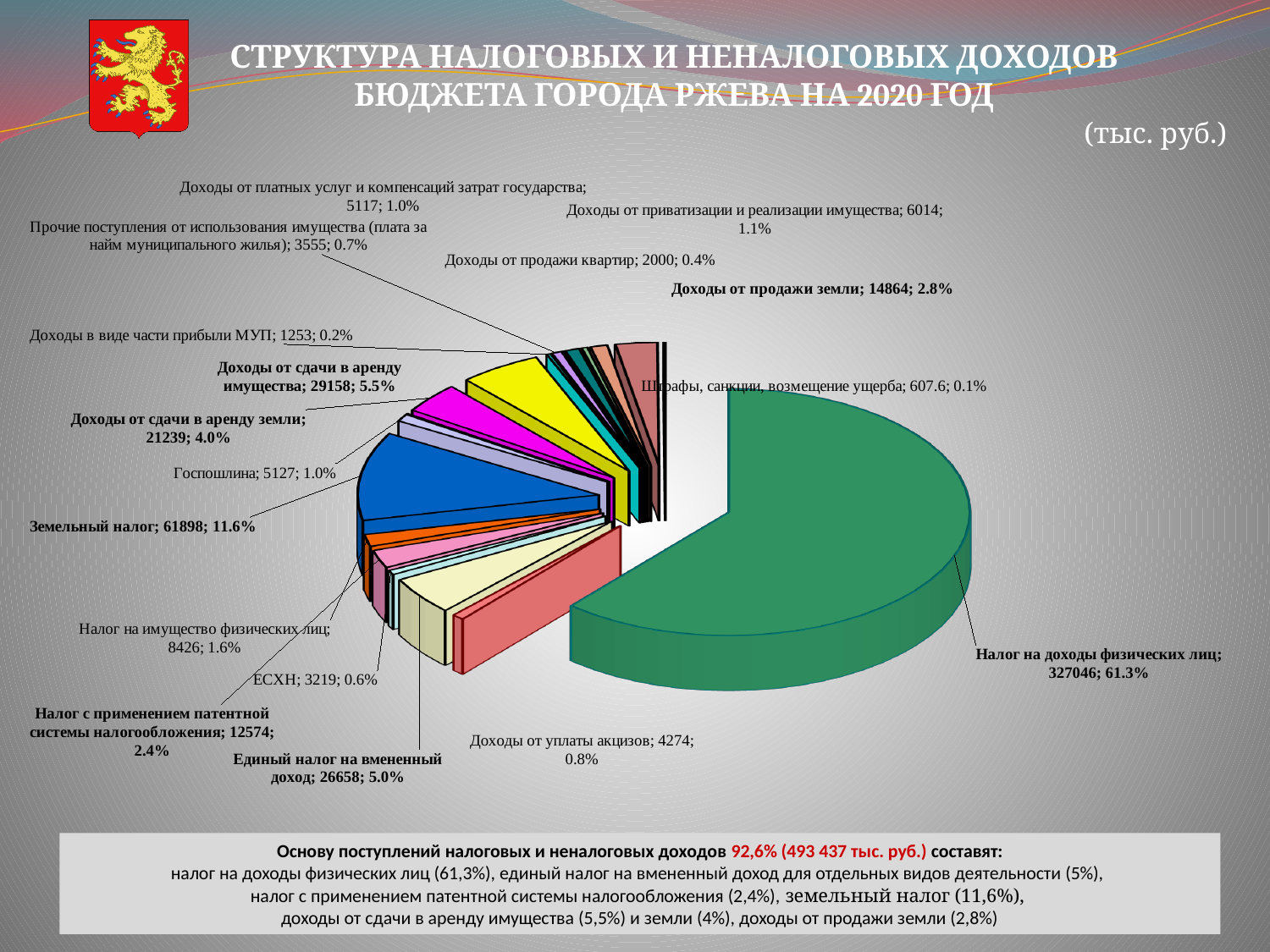
What is the value for Налог на доходы физических лиц? 327046 What kind of chart is shown on the slide? pie chart What share of the pie does Налог на доходы физических лиц represent? 61.3% What unit is stated for the values in the chart? тыс. руб. What is the value for Доходы от продажи земли? 14864 What is the value for Земельный налог? 61898 What is the difference between the values for Доходы от сдачи в аренду имущества and Доходы от сдачи в аренду земли? 7919 What share of the pie does Доходы от сдачи в аренду имущества represent? 5.5% Which category has the largest slice of the pie? Налог на доходы физических лиц Which is larger: Единый налог на вмененный доход or Налог с применением патентной системы налогообложения? Единый налог на вмененный доход How many categories are shown in the pie chart? 17